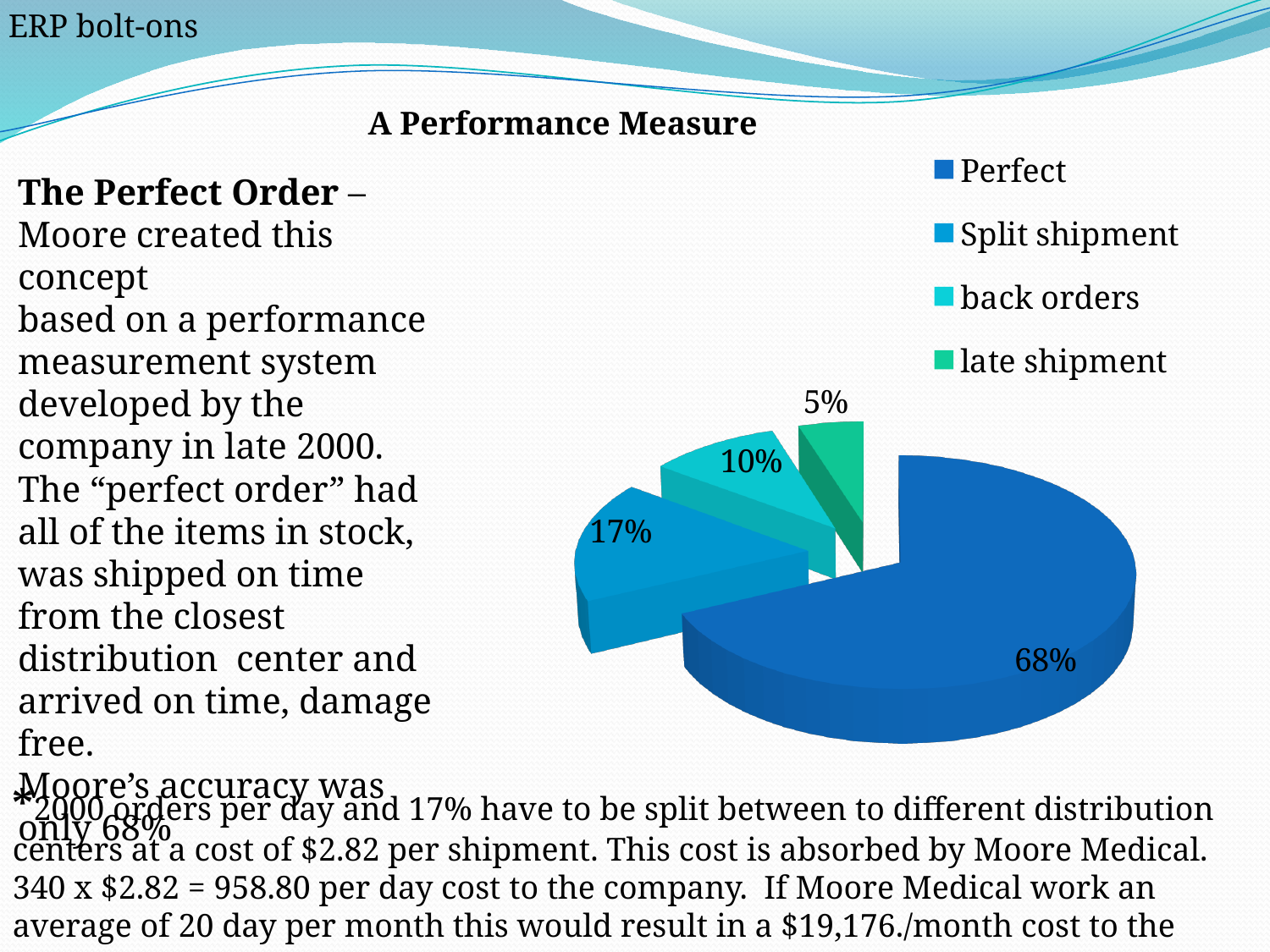
What percentage is shown for the back orders slice? 10% What percentage is shown for the Split shipment slice? 17% How many entries does the chart legend list? 4 What is the difference in percentage points between the Perfect slice and the Split shipment slice? 51 How many slices does the pie chart have? 4 What percentage is shown for the late shipment slice? 5% Which slice is larger, back orders or late shipment? back orders Which category has the largest slice of the pie chart? Perfect What is the combined percentage of the back orders and late shipment slices? 15% Which category has the smallest slice of the pie chart? late shipment What type of chart is shown on the slide? pie chart What percentage of the pie chart is labelled for the Perfect slice? 68%